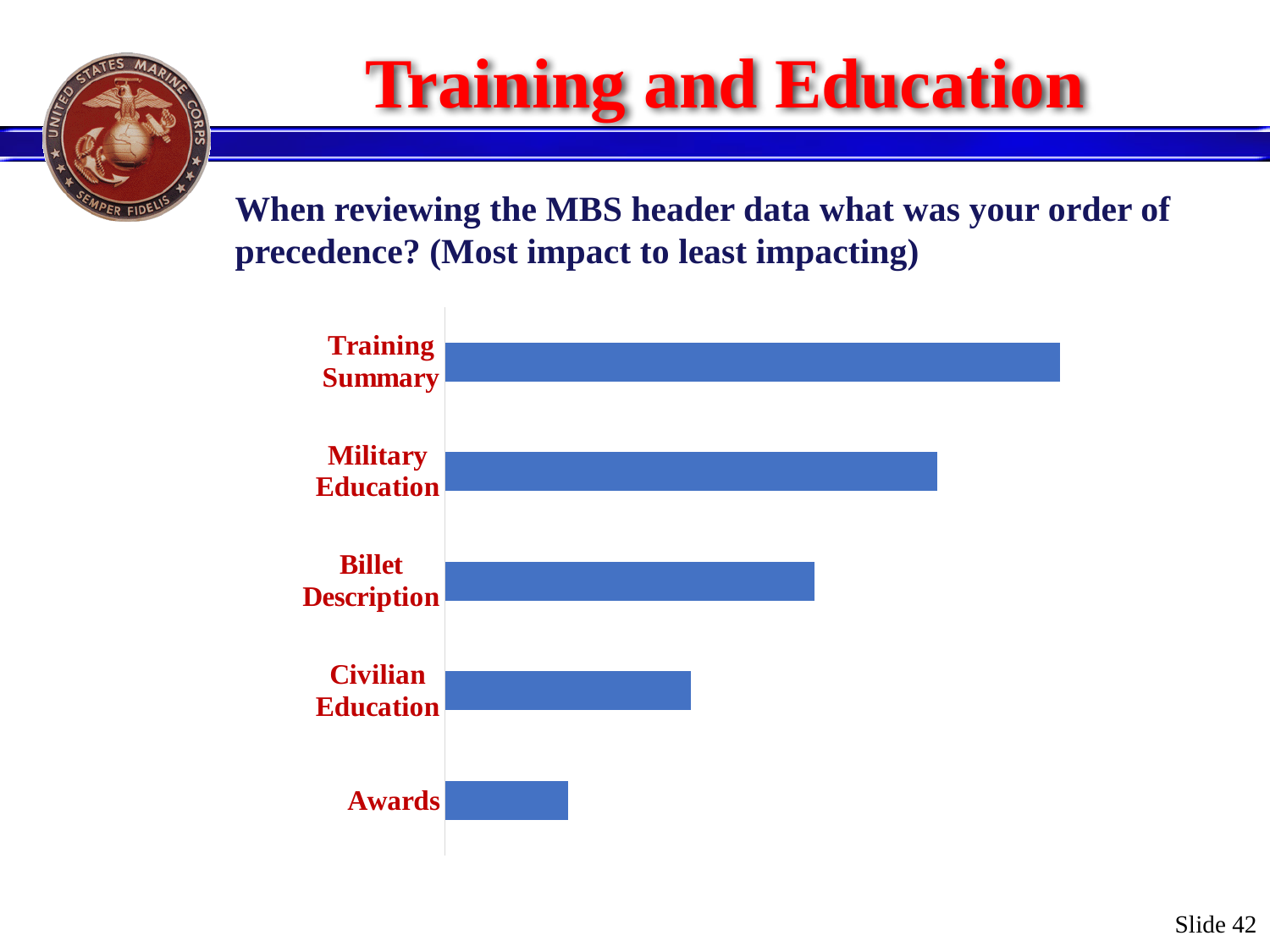
Do the bar lengths increase or decrease going from the top category to the bottom category? Decrease What colour are the bars in the chart? Blue Which has the larger value, Military Education or Billet Description? Military Education What kind of chart is shown on the slide? Bar chart Which category is listed second from the top in the chart? Military Education Which category has the shortest bar in the chart? Awards Which has the larger value, Training Summary or Military Education? Training Summary How many categories does the bar chart show? 5 Which has the larger value, Civilian Education or Awards? Civilian Education Which category has the longest bar in the chart? Training Summary